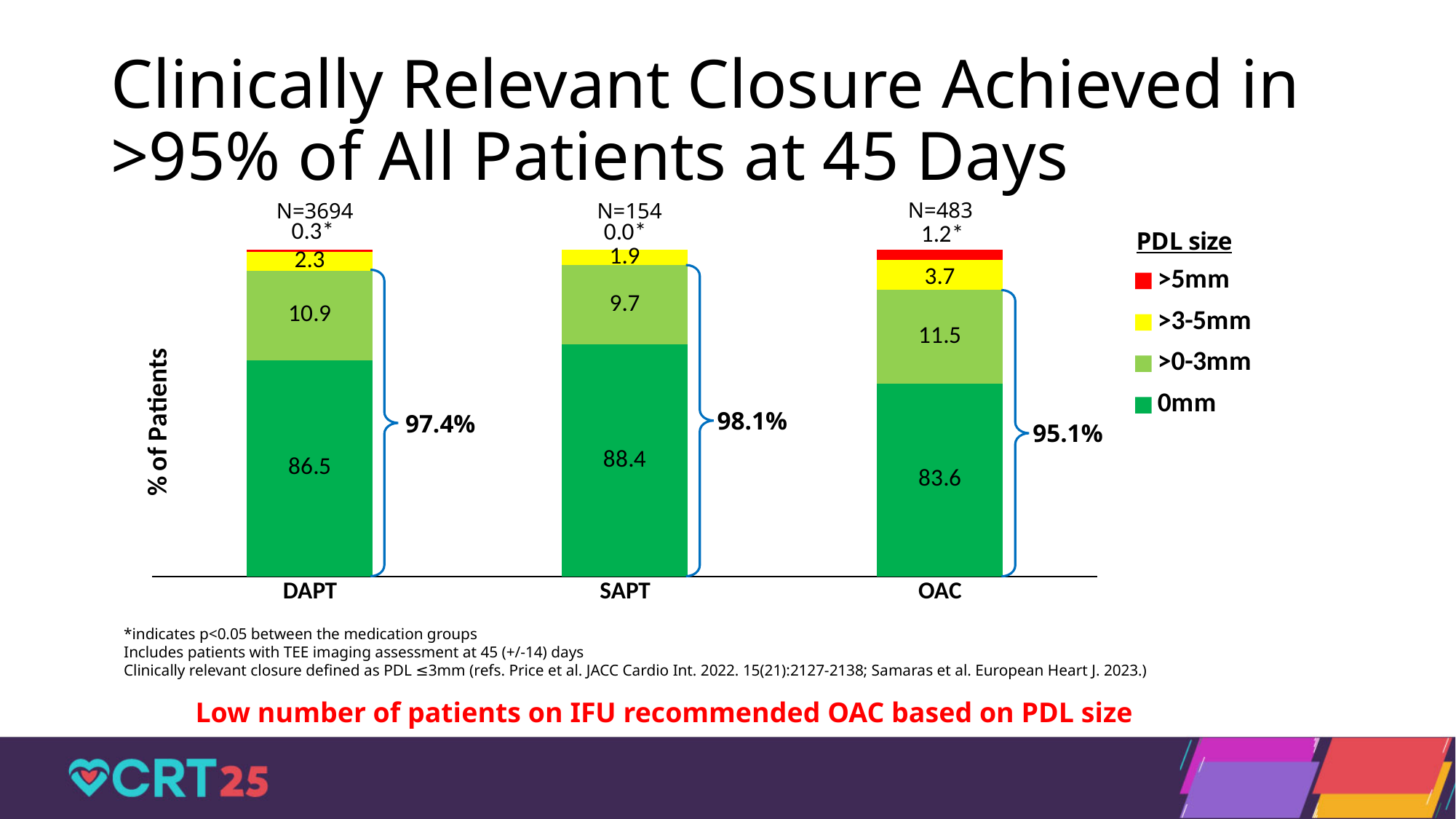
Which has the larger >3-5mm value, DAPT or OAC? OAC What is the value of the >0-3mm segment for SAPT? 9.7 Which medication group has the lowest 0mm value? OAC What is the difference between the 0mm values for SAPT and OAC? 4.8 What is the value of the 0mm segment for DAPT? 86.5 What kind of chart is shown on the slide? Stacked bar chart How many medication groups are shown on the x axis? 3 What is the N shown above the DAPT bar? N=3694 What is the value of the >5mm segment for OAC? 1.2 How many PDL size categories does the legend list? 4 Which medication group has the highest 0mm value? SAPT What is the value of the >3-5mm segment for OAC? 3.7